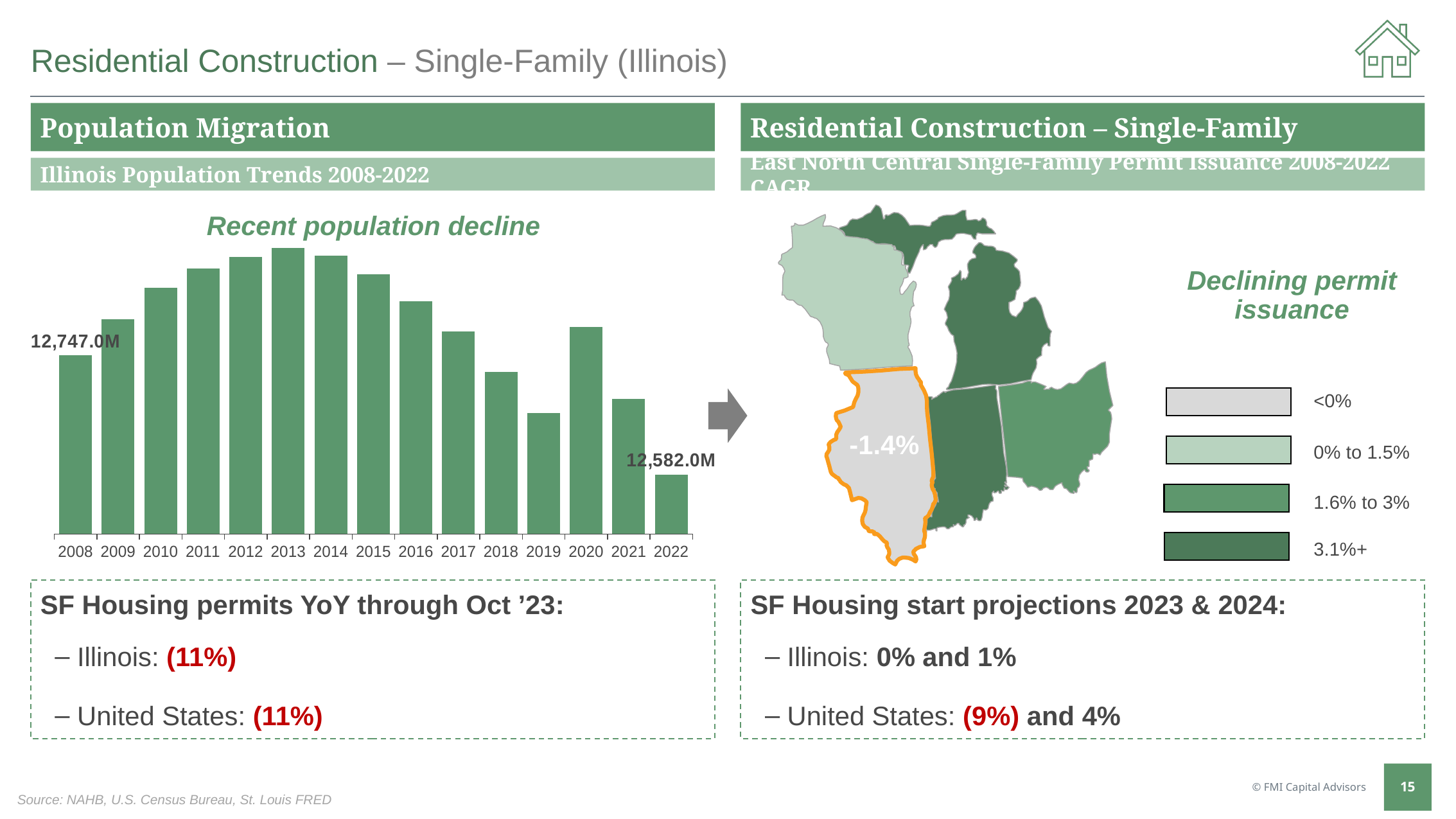
How many years are plotted in the Illinois Population Trends 2008-2022 bar chart? 15 In the Illinois Population Trends 2008-2022 bar chart, which year has the shortest bar? 2022 In the Illinois Population Trends 2008-2022 bar chart, which year has the larger value, 2008 or 2022? 2008 In the Illinois Population Trends 2008-2022 bar chart, what is the value shown for 2022? 12,582.0M In the Illinois Population Trends 2008-2022 bar chart, which year has the tallest bar? 2013 What annotation is written above the bars in the Illinois Population Trends 2008-2022 chart? Recent population decline On the East North Central Single-Family Permit Issuance map, what CAGR value is printed on Illinois? -1.4% In the Illinois Population Trends 2008-2022 bar chart, what is the value shown for 2008? 12,747.0M In the Illinois Population Trends 2008-2022 bar chart, do the values rise or fall from 2013 to 2019? Fall What kind of chart is used for Illinois Population Trends 2008-2022? Bar chart In the Illinois Population Trends 2008-2022 bar chart, what is the difference between the 2008 value and the 2022 value? 165.0M In the Illinois Population Trends 2008-2022 bar chart, which year has the larger value, 2013 or 2019? 2013